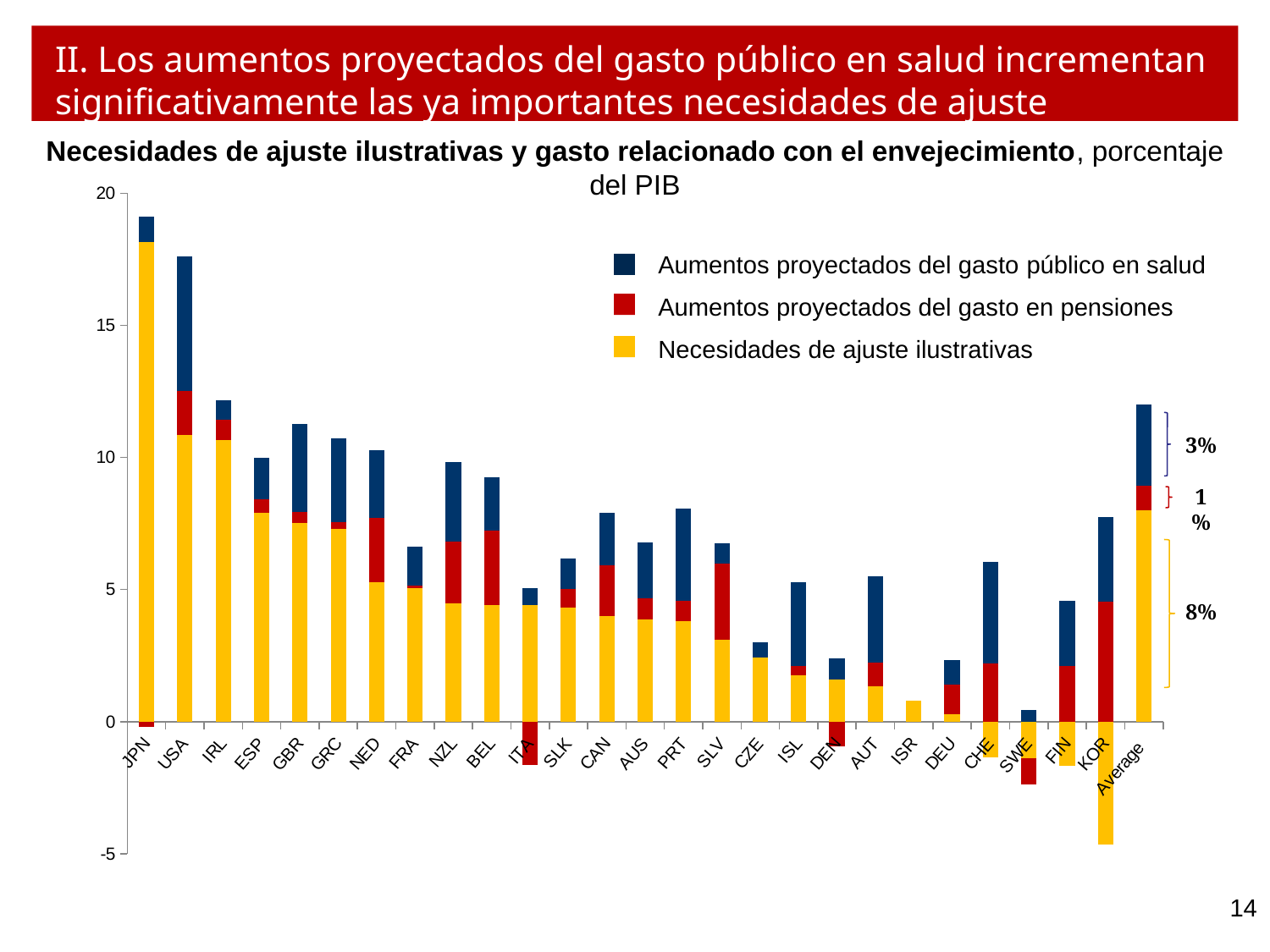
How many categories (countries plus Average) are shown on the x axis? 27 According to the annotation, what is the value of Aumentos proyectados del gasto público en salud for Average? 3% Is the total bar for ISR greater or less than 5? less Which has the larger Necesidades de ajuste ilustrativas value, JPN or USA? JPN According to the annotation, what is the value of Necesidades de ajuste ilustrativas for Average? 8% Which country has the lowest (most negative) value for Necesidades de ajuste ilustrativas? KOR What kind of chart is shown on the slide? Stacked bar chart How many series does the legend list? 3 According to the annotation, what is the value of Aumentos proyectados del gasto en pensiones for Average? 1% Is the value of Necesidades de ajuste ilustrativas for JPN greater or less than 15? greater Which category has the highest total bar? JPN Which colour represents Aumentos proyectados del gasto público en salud in the legend? Dark blue